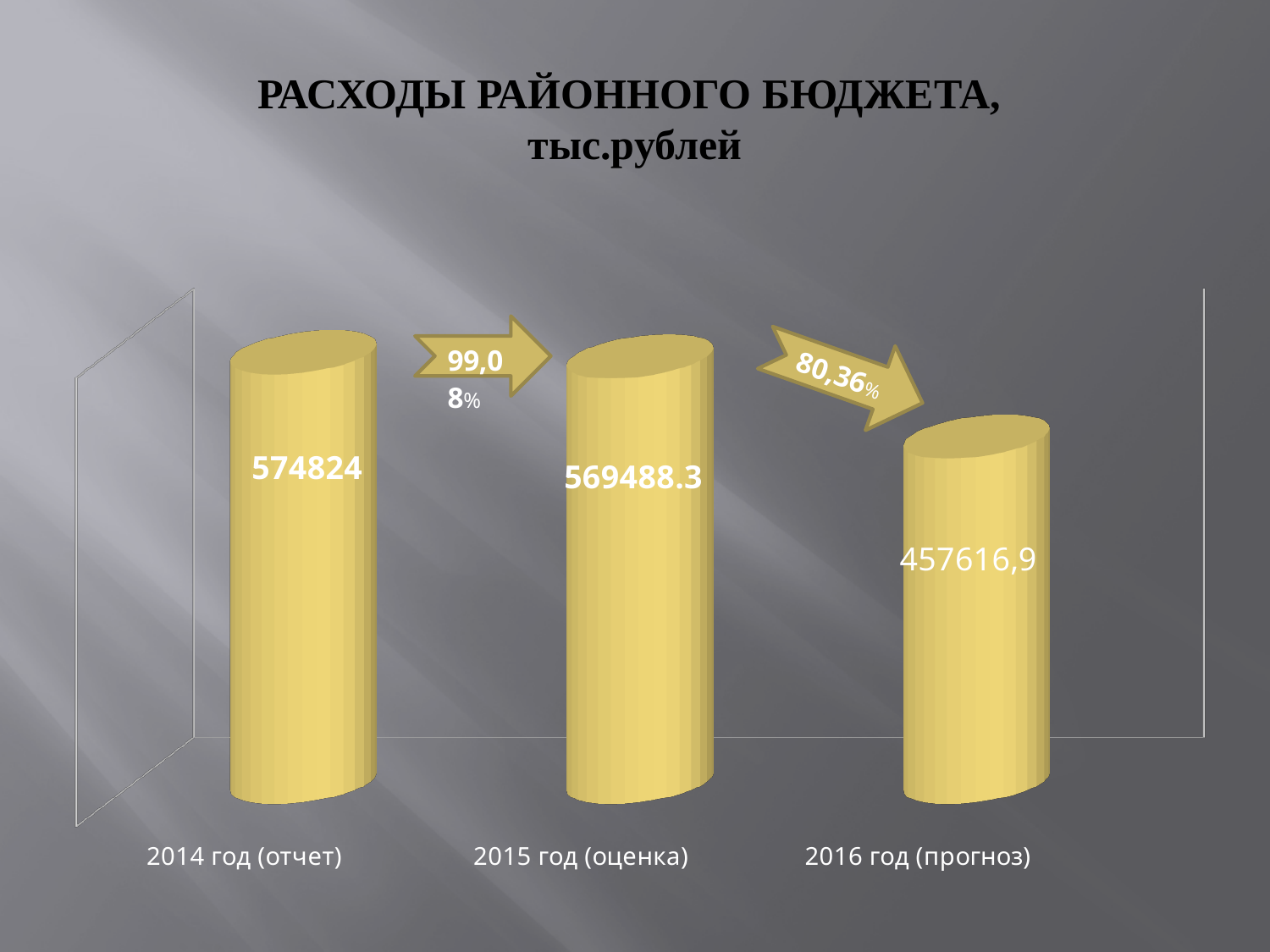
What is the title of the chart? РАСХОДЫ РАЙОННОГО БЮДЖЕТА, тыс.рублей What is the value for 2015 год (оценка)? 569488.3 Which category has the lowest value? 2016 год (прогноз) What is the value for 2016 год (прогноз)? 457616,9 What is the difference between the values for 2015 год (оценка) and 2016 год (прогноз)? 111871.4 What is the value for 2014 год (отчет)? 574824 What is the difference between the values for 2014 год (отчет) and 2015 год (оценка)? 5335.7 Which is larger, the value for 2014 год (отчет) or the value for 2016 год (прогноз)? 2014 год (отчет) How many categories are shown in the chart? 3 Do the values rise or fall from 2014 to 2016? Fall What kind of chart is shown on the slide? Bar chart Which category has the highest value? 2014 год (отчет)